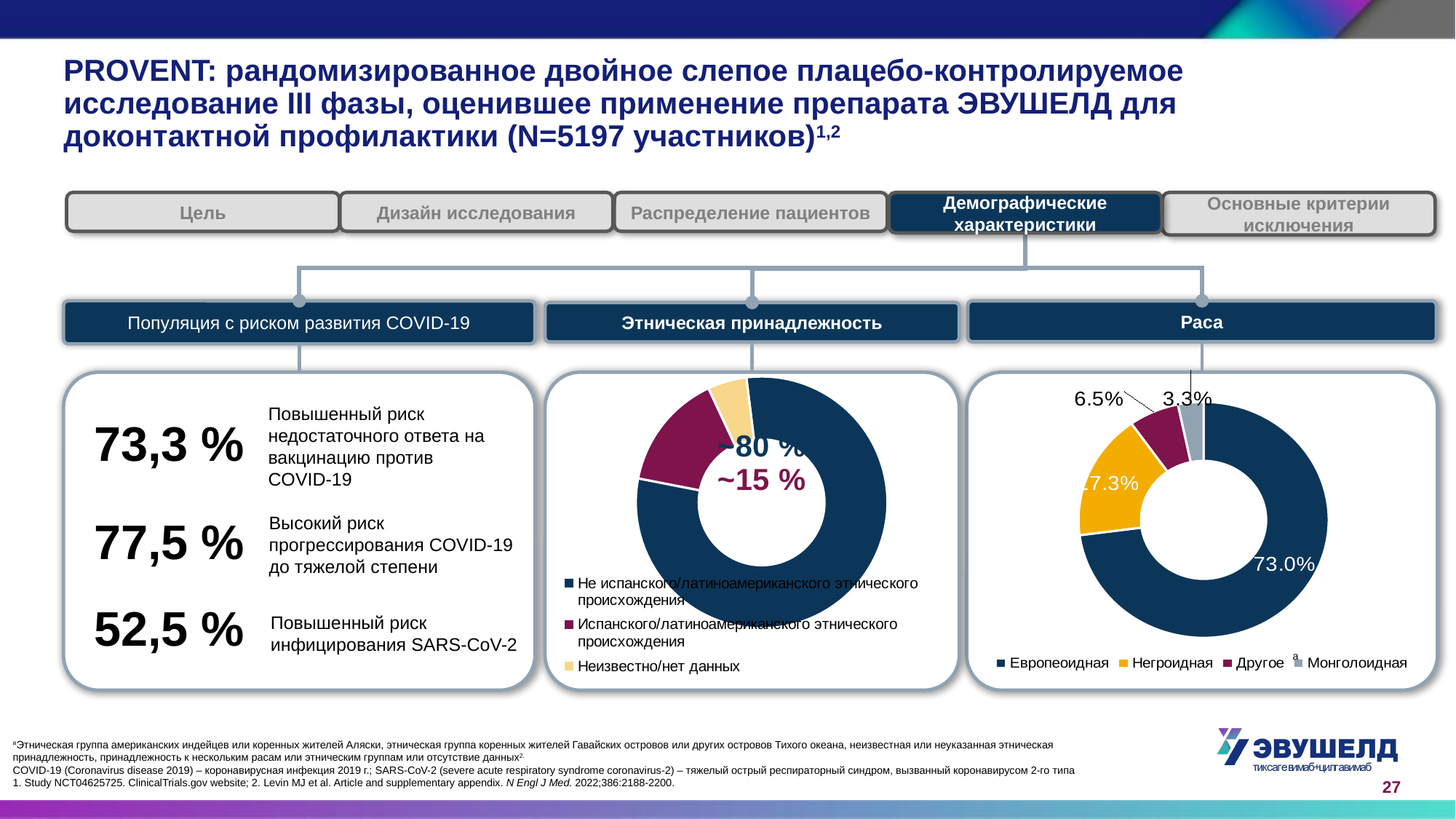
In the 'Раса' chart, which category has the smallest share? Монголоидная In the 'Этническая принадлежность' chart, which category has the largest share? Не испанского/латиноамериканского этнического происхождения What kind of chart is the 'Этническая принадлежность' chart? Pie (donut) chart How many entries does the legend of the 'Этническая принадлежность' chart list? 3 In the 'Раса' chart, which is larger: Другое or Монголоидная? Другое In the 'Раса' chart, what percentage is shown for Другое? 6.5% In the 'Раса' chart, what percentage is shown for Монголоидная? 3.3% In the 'Раса' chart, what is the difference between the Европеоидная and Негроидная shares? 55.7 percentage points How many categories does the 'Раса' chart show? 4 In the 'Раса' chart, what percentage is shown for Европеоидная? 73.0% In the 'Раса' chart, what percentage is shown for Негроидная? 17.3% In the 'Раса' chart, which category has the largest share? Европеоидная